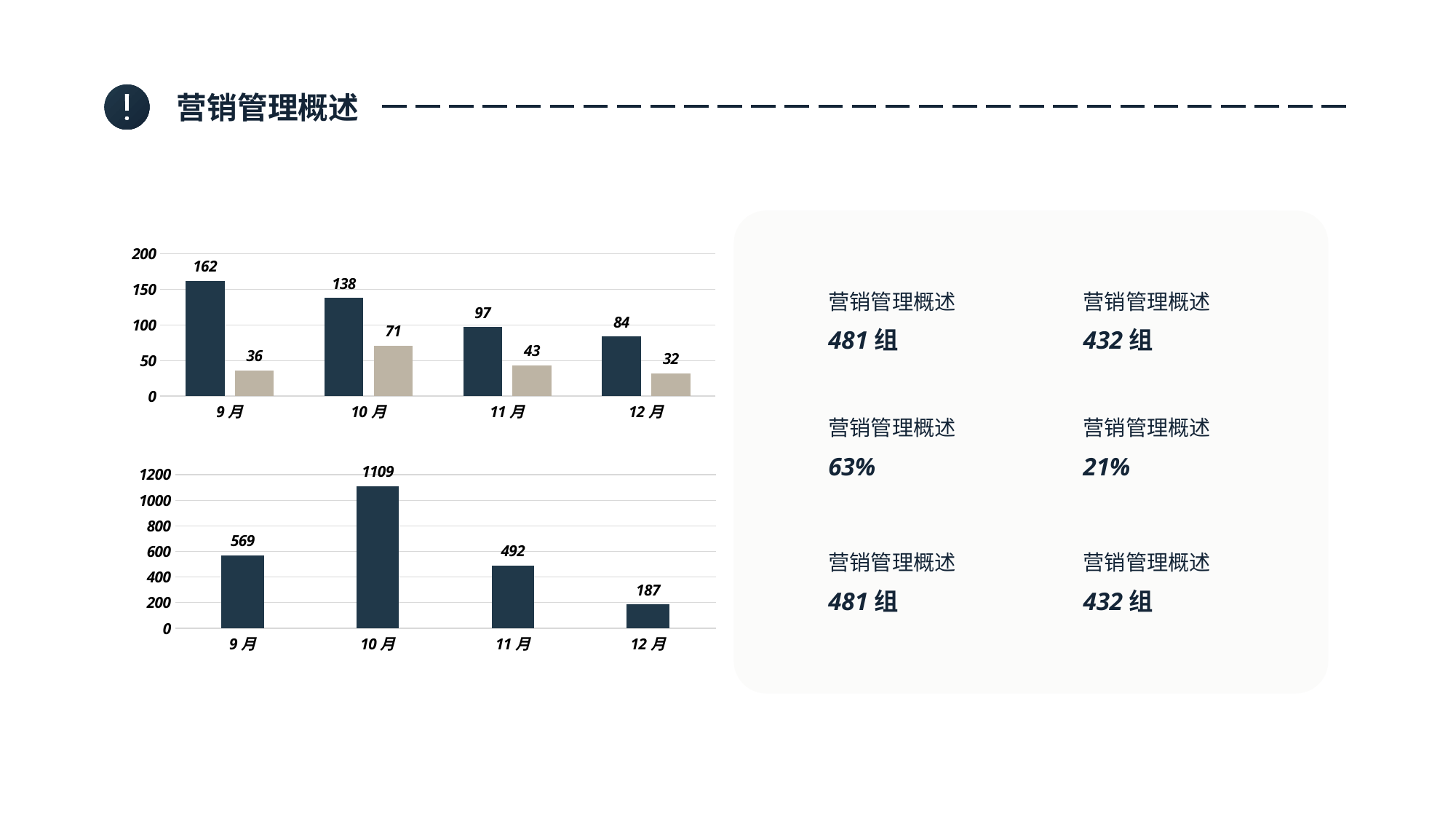
In the bottom chart, what is the difference between the values for 9 月 and 11 月? 77 In the top chart, which month has the lowest beige bar? 12 月 In the bottom chart, which month has the lowest value? 12 月 In the top chart, which month has the highest dark blue bar? 9 月 In the bottom chart, what is the value for 10 月? 1109 In the top chart, do the dark blue bars rise or fall from 9 月 to 12 月? fall In the top chart, how many months are shown on the x axis? 4 In the bottom chart, which is larger, the value for 9 月 or the value for 12 月? 9 月 What type of chart is the bottom chart? bar chart In the top chart, what is the value of the beige bar for 10 月? 71 In the top chart, what is the value of the dark blue bar for 9 月? 162 In the top chart, what is the difference between the dark blue bar and the beige bar for 11 月? 54